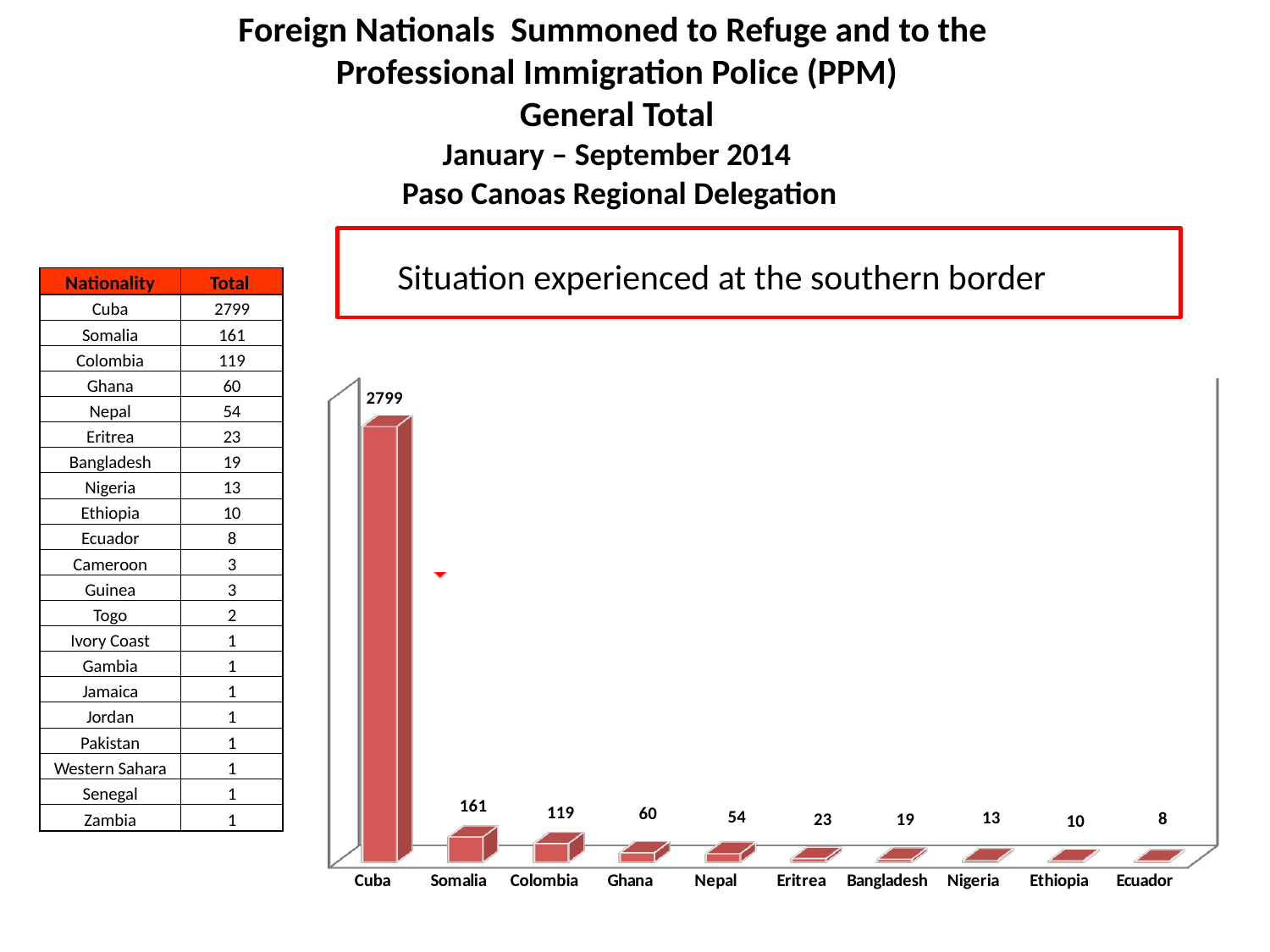
Do the values in the bar chart rise or fall from left to right along the x axis? fall Which category has the lowest value in the bar chart? Ecuador Which category has the highest value in the bar chart? Cuba Which has a larger value in the bar chart, Ghana or Eritrea? Ghana What is the difference between the values for Somalia and Colombia in the bar chart? 42 What is the value for Cuba in the bar chart? 2799 What is the value for Somalia in the bar chart? 161 What kind of chart is shown on the slide? bar chart What is the value for Nepal in the bar chart? 54 What is the value for Ethiopia in the bar chart? 10 How many categories are shown on the x axis of the bar chart? 10 What is the difference between the values for Cuba and Somalia in the bar chart? 2638